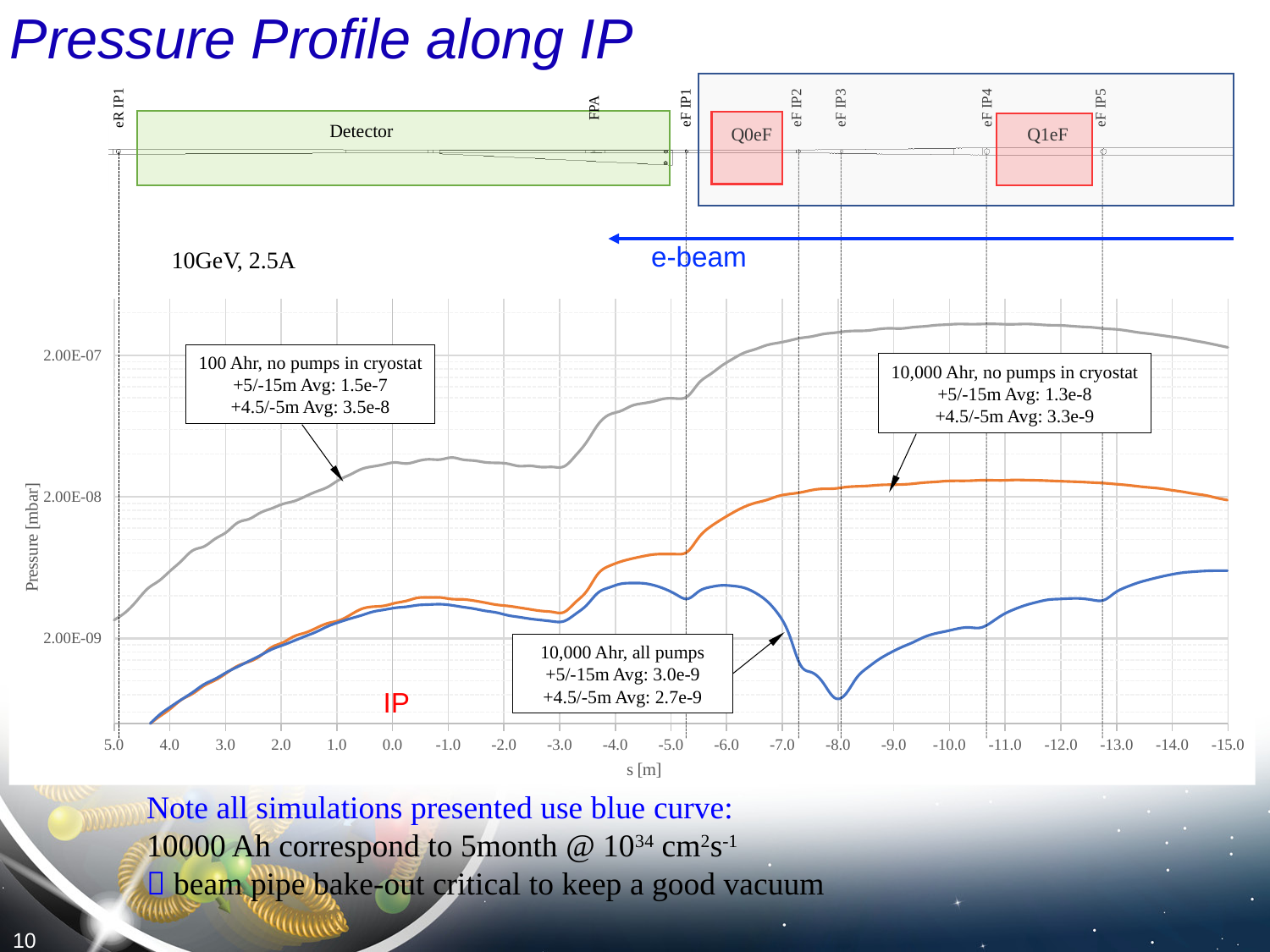
What is the +4.5/-5m average pressure for the '100 Ahr, no pumps in cryostat' curve? 3.5e-8 What is the +5/-15m average pressure for the '10,000 Ahr, no pumps in cryostat' curve? 1.3e-8 Which is larger, the +4.5/-5m average for '10,000 Ahr, no pumps in cryostat' or for '10,000 Ahr, all pumps'? 10,000 Ahr, no pumps in cryostat What is the +5/-15m average pressure for the '100 Ahr, no pumps in cryostat' curve? 1.5e-7 How many pressure curves are plotted on the chart? 3 Does the gray '100 Ahr, no pumps in cryostat' curve rise or fall as s goes from 5.0 m to -10.0 m? rise Is the pressure of the gray '100 Ahr, no pumps in cryostat' curve at s = -10.0 m greater or less than 2.00E-07 mbar? greater Which curve has the highest +5/-15m average pressure? 100 Ahr, no pumps in cryostat What is the label of the vertical axis of the chart? Pressure [mbar] Which curve has the lowest +5/-15m average pressure? 10,000 Ahr, all pumps What kind of chart is shown on the slide? line chart What is the +4.5/-5m average pressure for the '10,000 Ahr, all pumps' curve? 2.7e-9